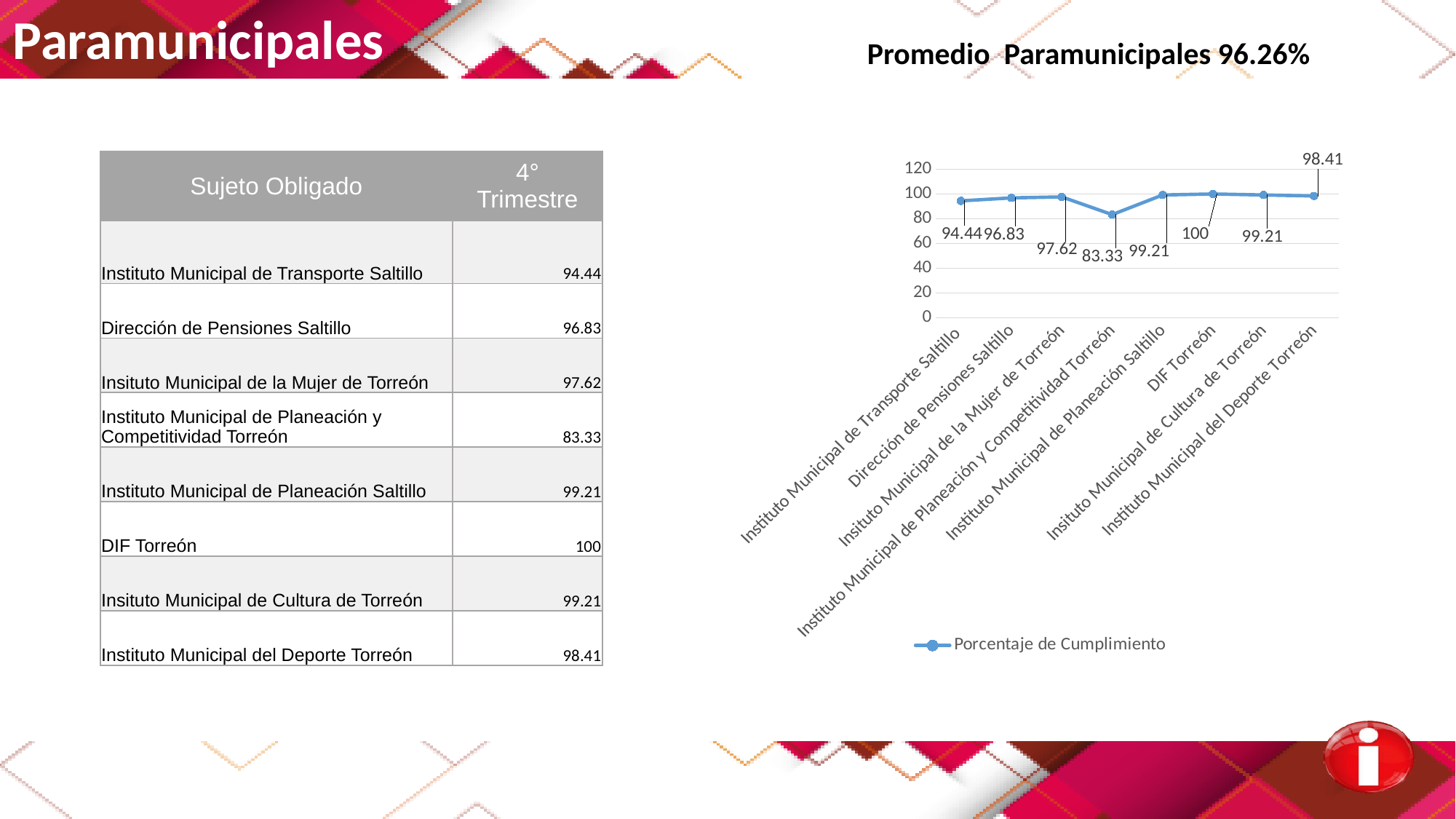
What type of chart is shown on the slide? Line chart What is the value for DIF Torreón in the chart? 100 Which category has the highest value in the chart? DIF Torreón What is the value for Instituto Municipal de Transporte Saltillo in the chart? 94.44 How many series does the chart legend list? 1 What is the name of the series shown in the chart legend? Porcentaje de Cumplimiento What is the value for Instituto Municipal de Planeación y Competitividad Torreón in the chart? 83.33 Which is larger: the value for Dirección de Pensiones Saltillo or the value for Instituto Municipal de Transporte Saltillo? Dirección de Pensiones Saltillo Which category has the lowest value in the chart? Instituto Municipal de Planeación y Competitividad Torreón What is the difference between the values for DIF Torreón and Instituto Municipal de Planeación y Competitividad Torreón? 16.67 How many categories are plotted on the x axis of the chart? 8 What is the value for Instituto Municipal del Deporte Torreón in the chart? 98.41